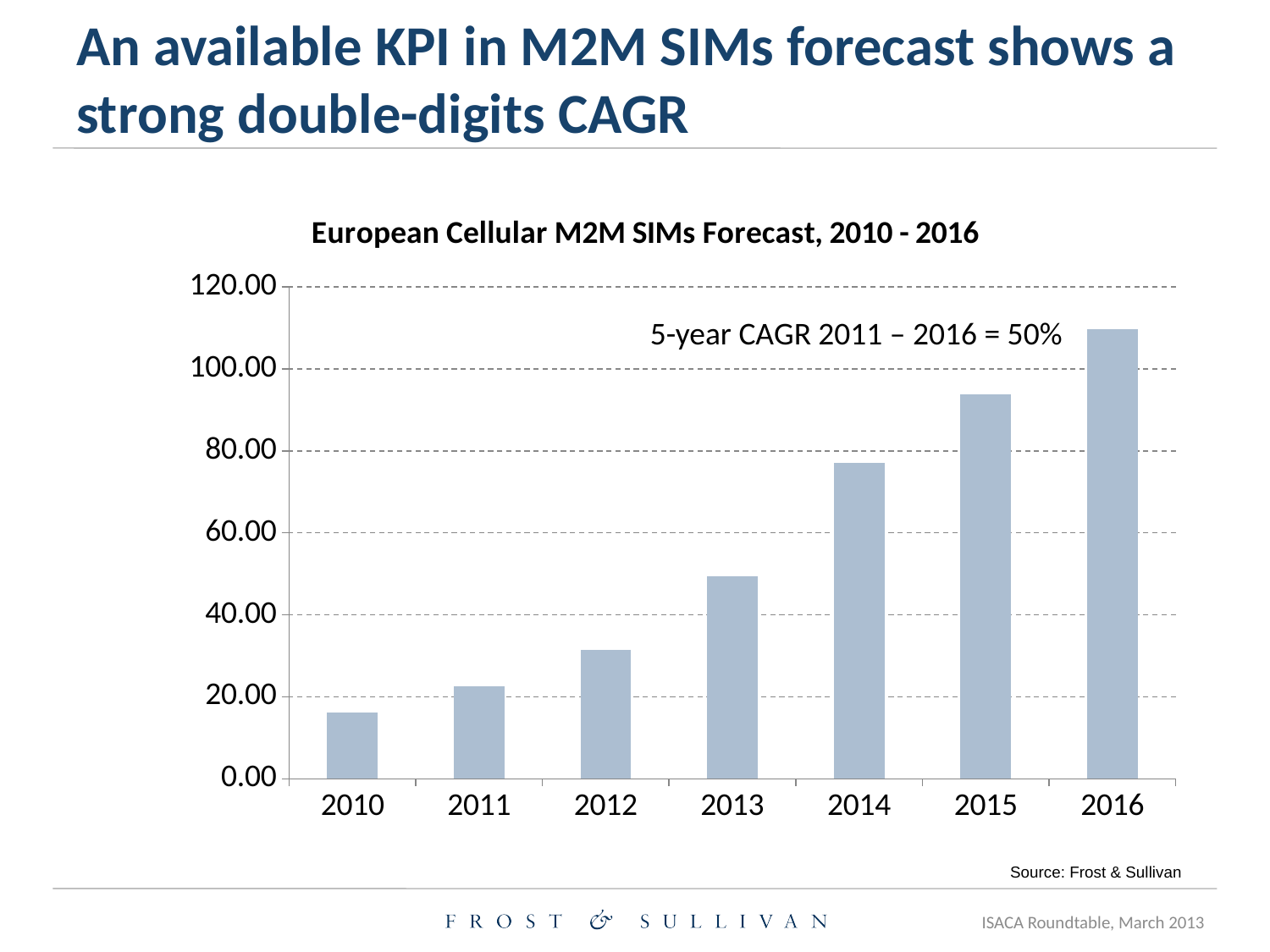
Is the value for 2016 greater or less than 100.00? greater Which year has the highest value? 2016 Which is larger, the value for 2012 or the value for 2014? 2014 Is the value for 2010 greater or less than 20.00? less What type of chart is shown on the slide? bar chart Is the value for 2013 greater or less than 40.00? greater How many years are plotted on the x axis? 7 Do the values rise or fall from 2010 to 2016? rise What is the title of the chart? European Cellular M2M SIMs Forecast, 2010 - 2016 Which year has the lowest value? 2010 What 5-year CAGR for 2011 – 2016 is stated on the chart? 50%